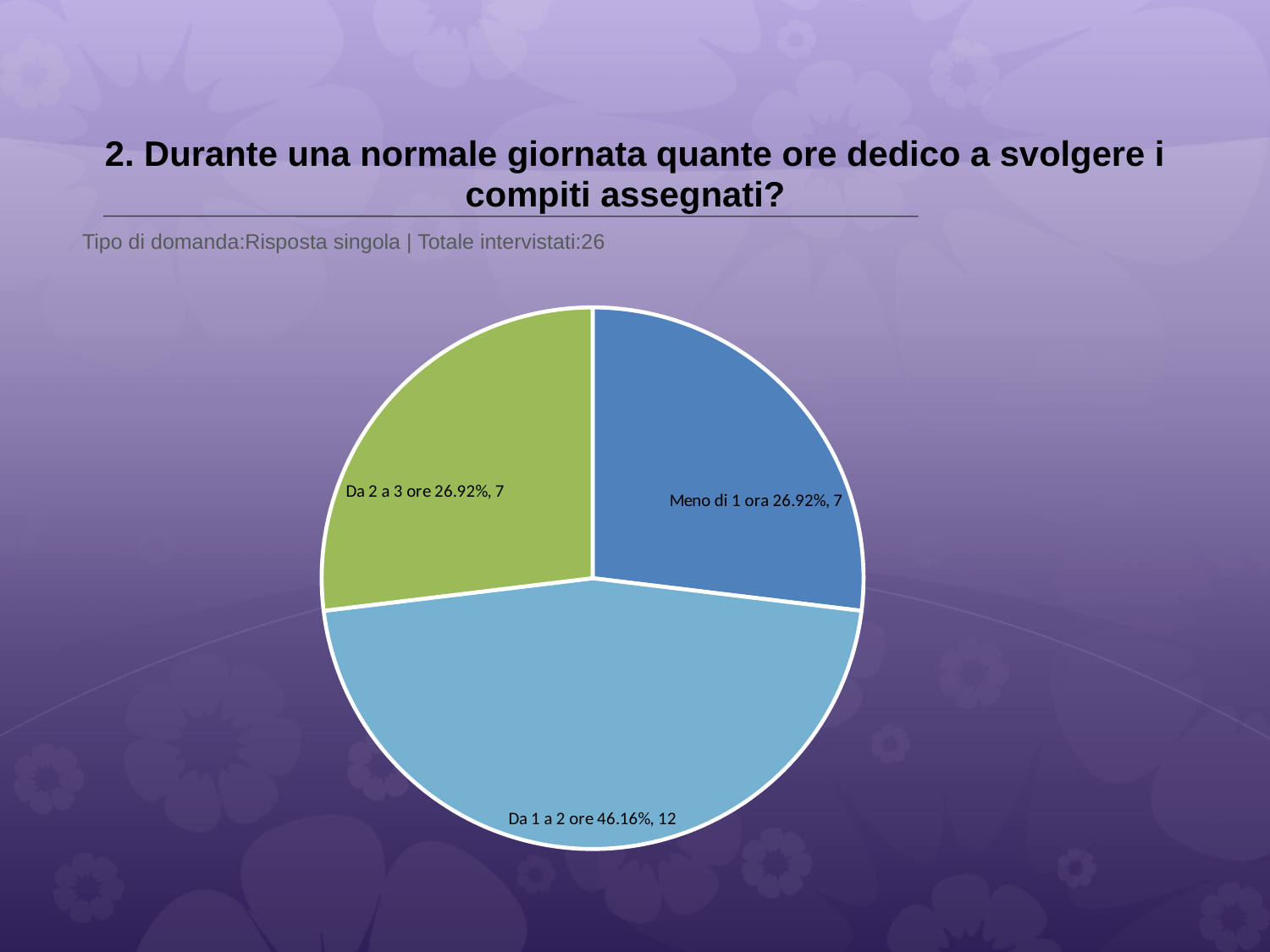
What percentage share does "Da 1 a 2 ore" have? 46.16% Which is larger, the count for "Da 1 a 2 ore" or the count for "Da 2 a 3 ore"? Da 1 a 2 ore How many slices does the pie chart have? 3 Which category has the largest slice? Da 1 a 2 ore What percentage share does "Meno di 1 ora" have? 26.92% What kind of chart is shown on the slide? pie chart What colour is the "Da 2 a 3 ore" slice? green What is the total number of interviewees stated on the slide? 26 What is the difference in count between "Da 1 a 2 ore" and "Meno di 1 ora"? 5 What is the total number of respondents across all slices? 26 What is the count for "Da 2 a 3 ore"? 7 What is the count for "Da 1 a 2 ore"? 12